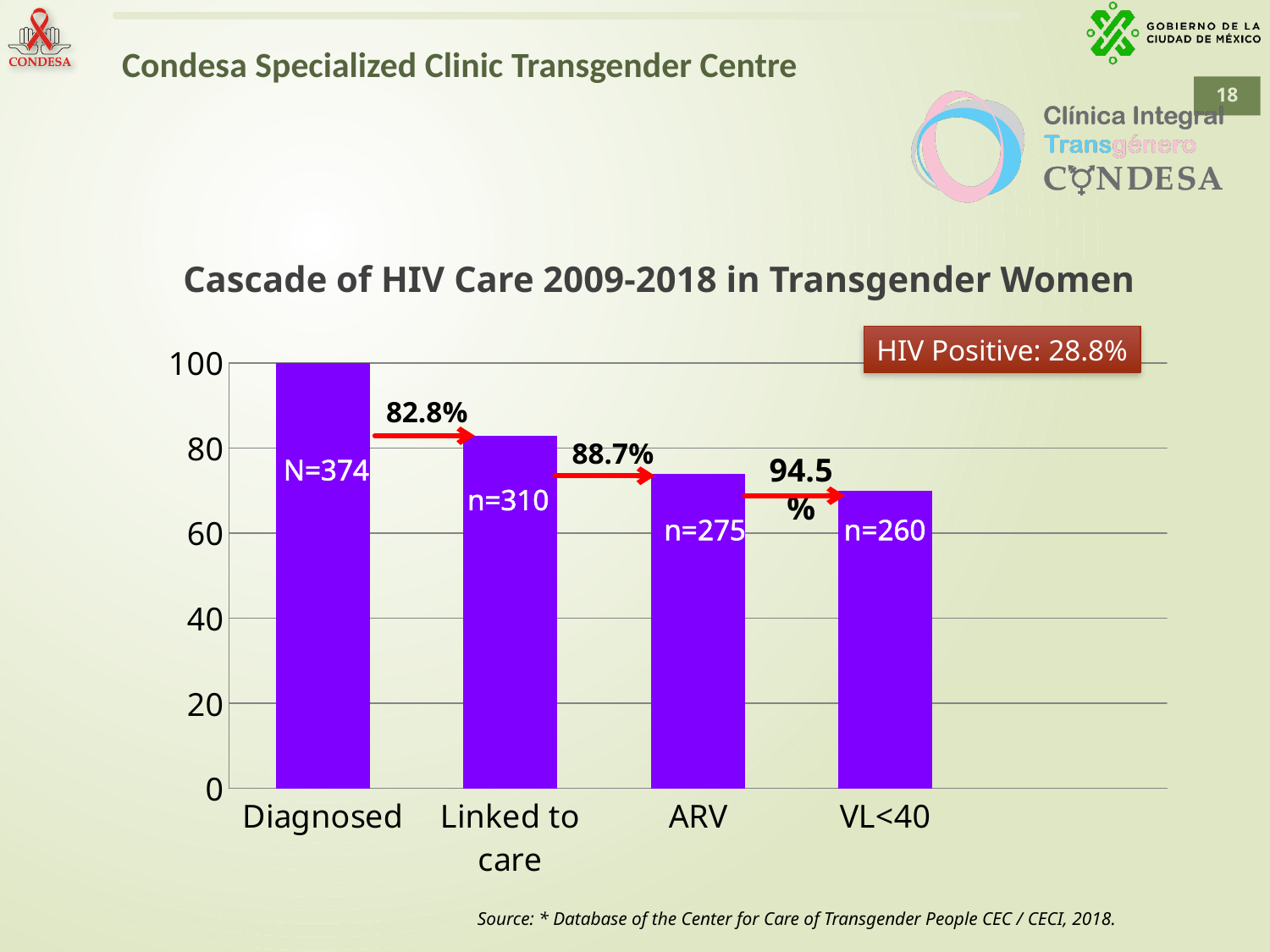
What is the n value printed on the Linked to care bar? n=310 What is the difference between the number of people Diagnosed (N=374) and Linked to care (n=310)? 64 What is the n value printed on the ARV bar? n=275 What kind of chart is shown on the slide? bar chart What is the N value printed on the Diagnosed bar? N=374 Which category has the highest bar? Diagnosed How many categories are shown on the x axis of the chart? 4 Do the bar values rise or fall from Diagnosed to VL<40? fall What is the n value printed on the VL<40 bar? n=260 What percentage is printed on the arrow between the Diagnosed and Linked to care bars? 82.8% Which category has the lowest bar? VL<40 Is the value for ARV greater or less than 80? less